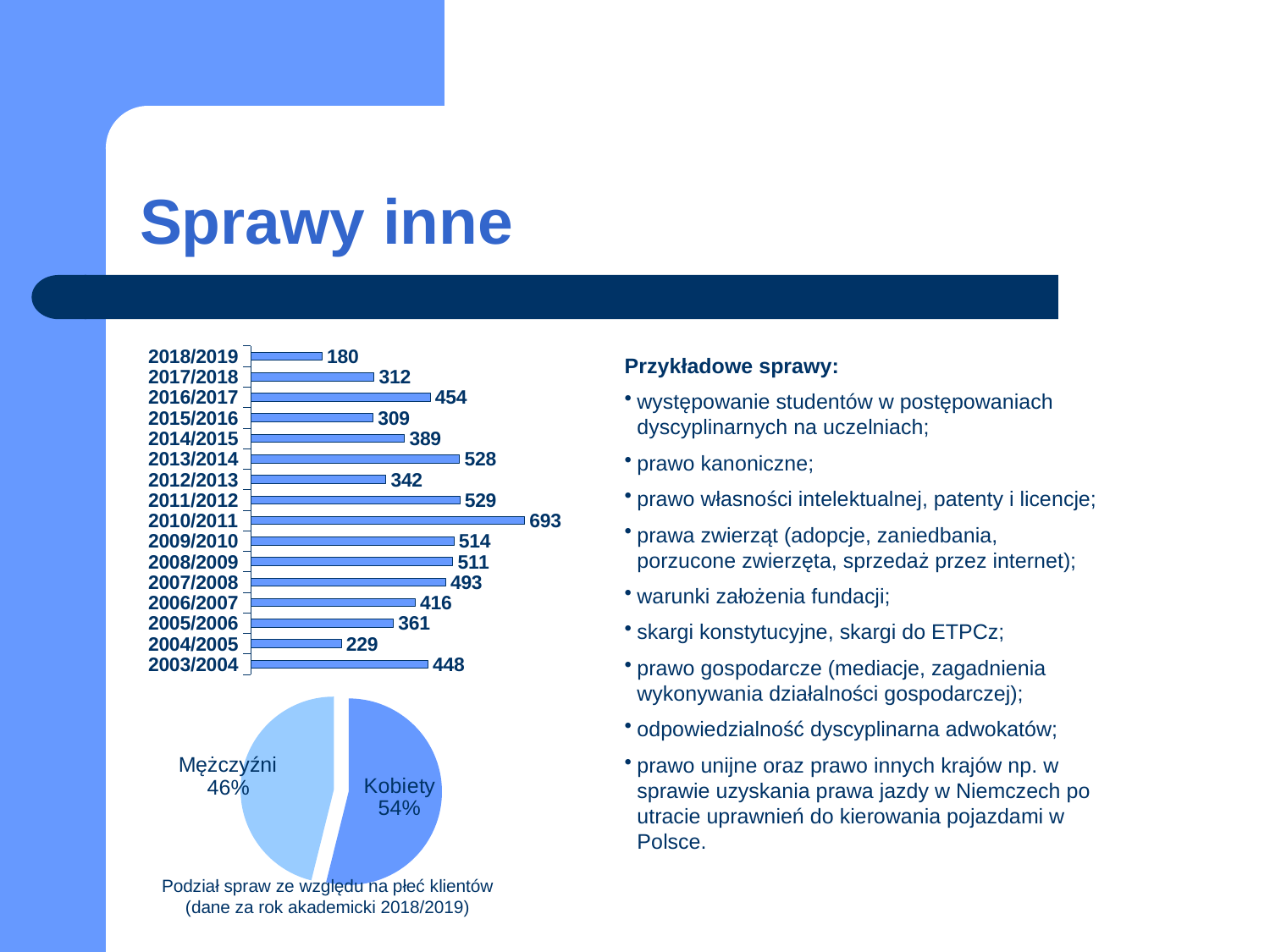
In the pie chart at the bottom left, what share is labelled Kobiety? 54% In the bar chart on the left, which academic year has the lowest value? 2018/2019 In the bar chart on the left, what is the value for 2010/2011? 693 In the bar chart on the left, which academic year has the highest value? 2010/2011 In the bar chart on the left, what is the difference between the values for 2016/2017 and 2017/2018? 142 In the bar chart on the left, which is larger: the value for 2013/2014 or the value for 2012/2013? 2013/2014 What type of chart is the lower chart on the left of the slide? Pie chart How many academic years are shown in the bar chart on the left? 16 In the bar chart on the left, what is the value for 2003/2004? 448 In the pie chart at the bottom left, what share is labelled Mężczyźni? 46% What type of chart is the upper chart on the left of the slide? Bar chart In the pie chart at the bottom left, which slice is larger: Kobiety or Mężczyźni? Kobiety